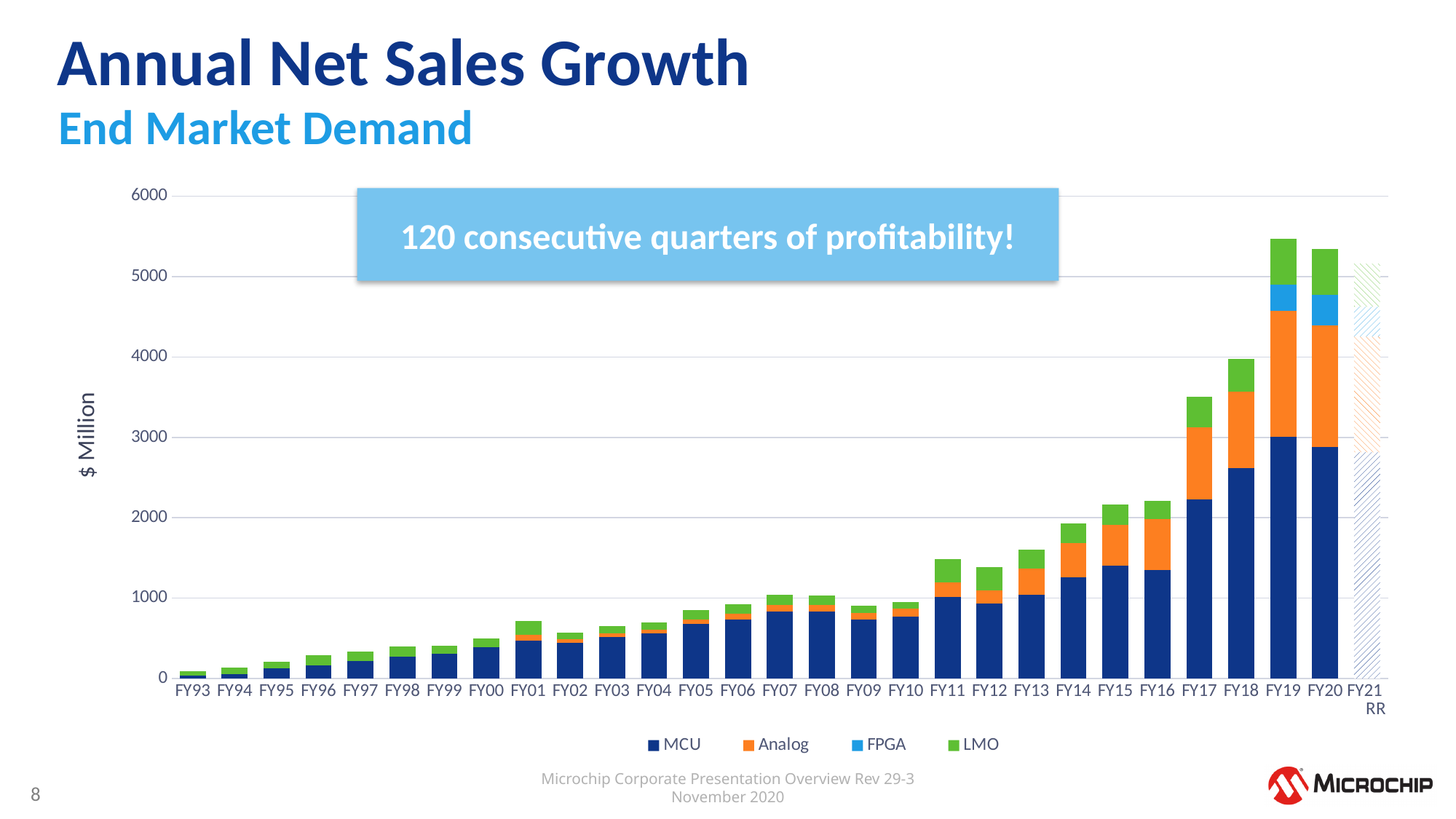
What unit is shown on the y-axis label? $ Million Do the total net sales values generally rise or fall from FY93 to FY20? rise How many fiscal-year categories are shown along the x axis? 29 Which fiscal year has the tallest stacked bar? FY19 Is the MCU segment for FY20 greater or less than 3000? less How many series does the legend list? 4 What kind of chart is shown on the slide? Stacked bar chart Is the total net sales value for FY17 greater or less than 3000? greater Is the total net sales value for FY10 greater or less than 1000? less Which has the larger total net sales, FY17 or FY18? FY18 Which fiscal year has the shortest stacked bar? FY93